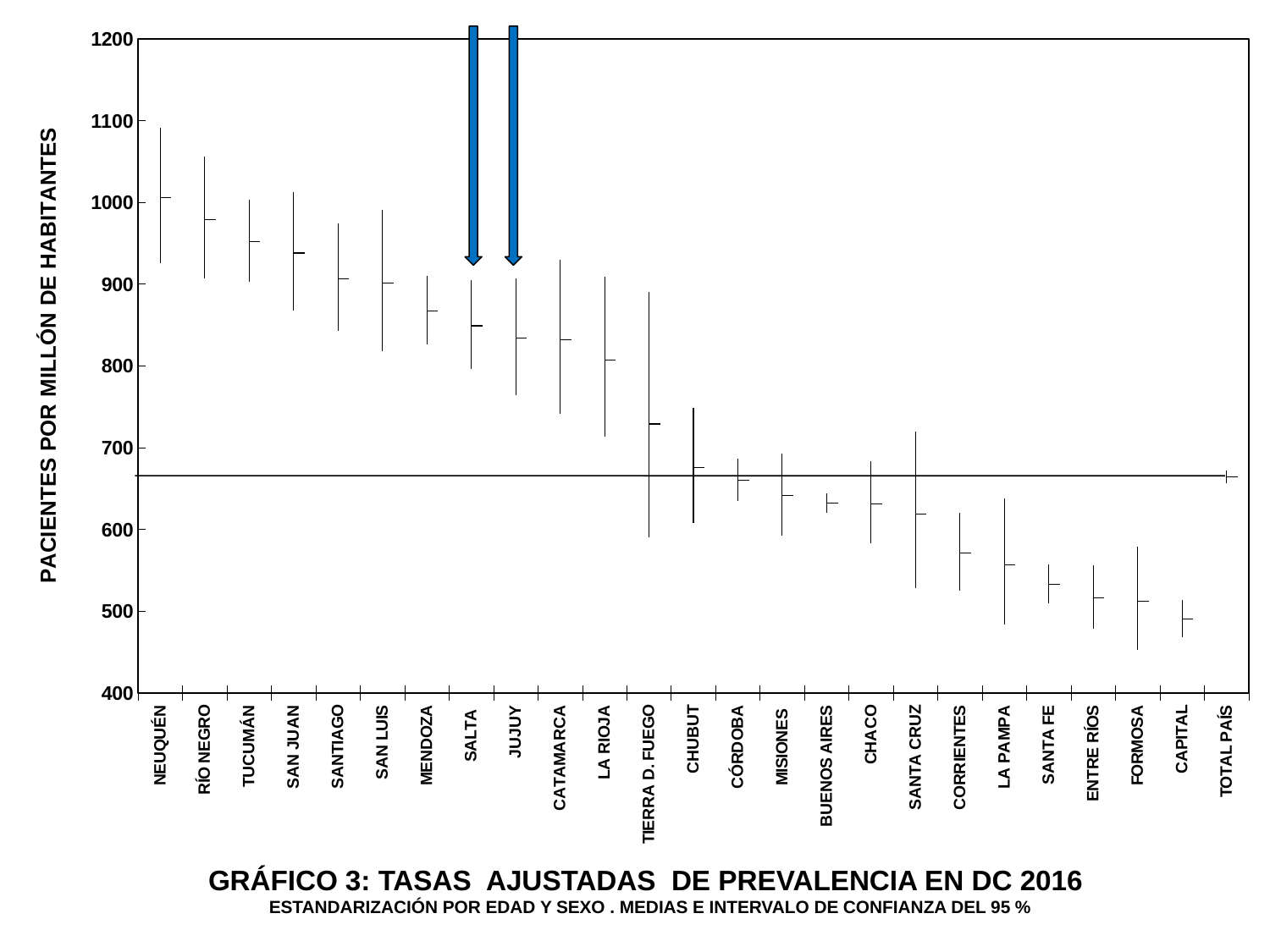
Is the mean value for CAPITAL greater or less than 600? less What is the label of the y axis? PACIENTES POR MILLÓN DE HABITANTES Is the mean value for CHUBUT greater or less than 700? less Which two provinces are marked with blue arrows on the chart? SALTA and JUJUY Do the mean values rise or fall moving from left to right along the x axis? fall Is the mean value for SANTA FE greater or less than 600? less Which has the larger mean value, TUCUMÁN or SANTA FE? TUCUMÁN Which category has the highest mean prevalence rate? NEUQUÉN How many categories are shown along the x axis? 25 Which category has the lowest mean prevalence rate? CAPITAL